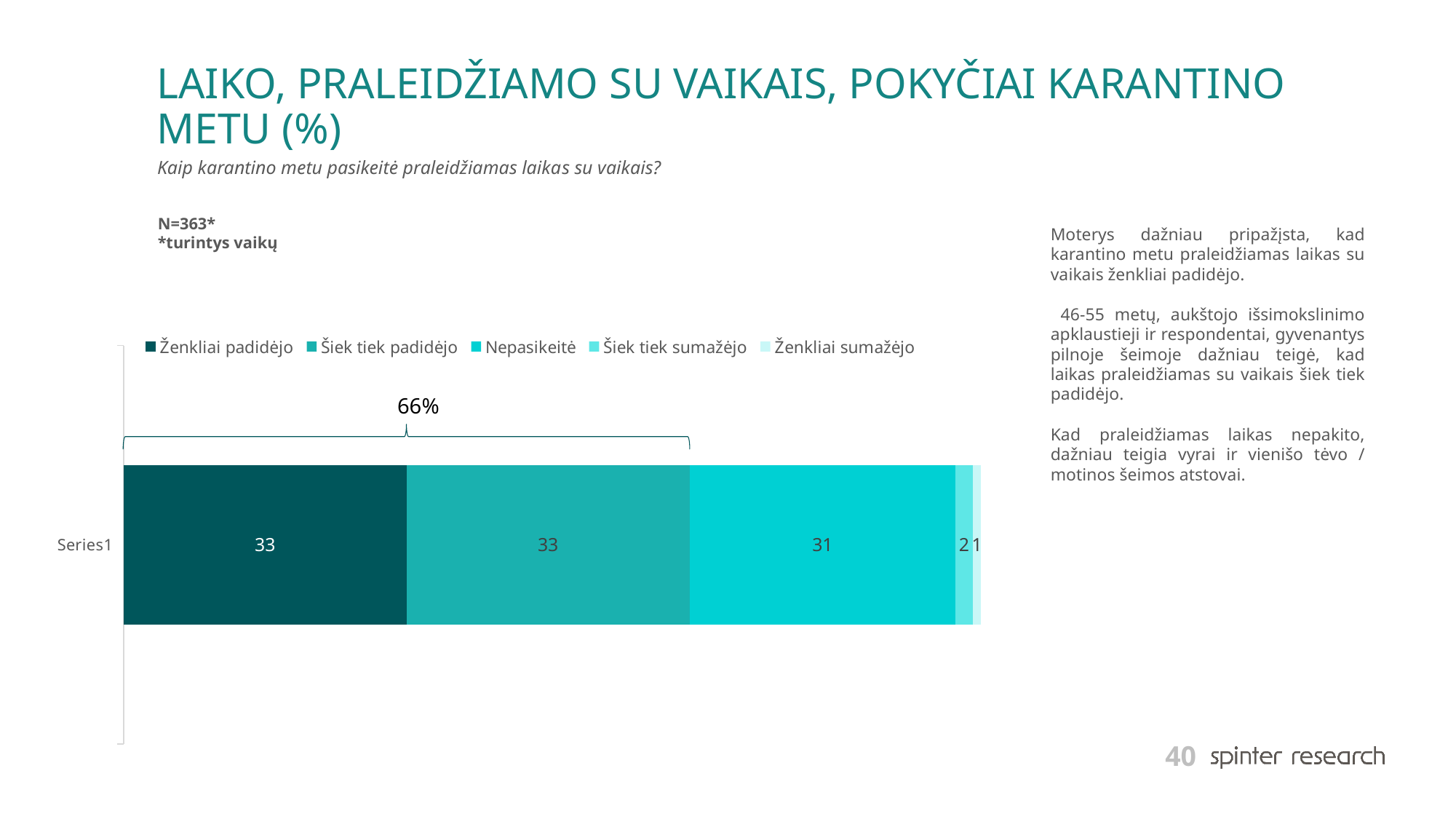
Which series has the smallest value in the stacked bar? Ženkliai sumažėjo What sample size (N) is stated on the slide for the chart? N=363* How many series does the legend list? 5 What is the difference between the values for "Nepasikeitė" and "Šiek tiek sumažėjo"? 29 What kind of chart is shown on the slide? Stacked bar chart What is the value for "Nepasikeitė" in the stacked bar? 31 Which is larger, the value for "Šiek tiek padidėjo" or the value for "Nepasikeitė"? Šiek tiek padidėjo What combined percentage is shown by the bracket above the first two segments of the bar? 66% What is the total of the stacked bar across all five series? 100 What is the value for "Šiek tiek sumažėjo" in the stacked bar? 2 What is the value for "Ženkliai sumažėjo" in the stacked bar? 1 What is the value for "Ženkliai padidėjo" in the stacked bar? 33